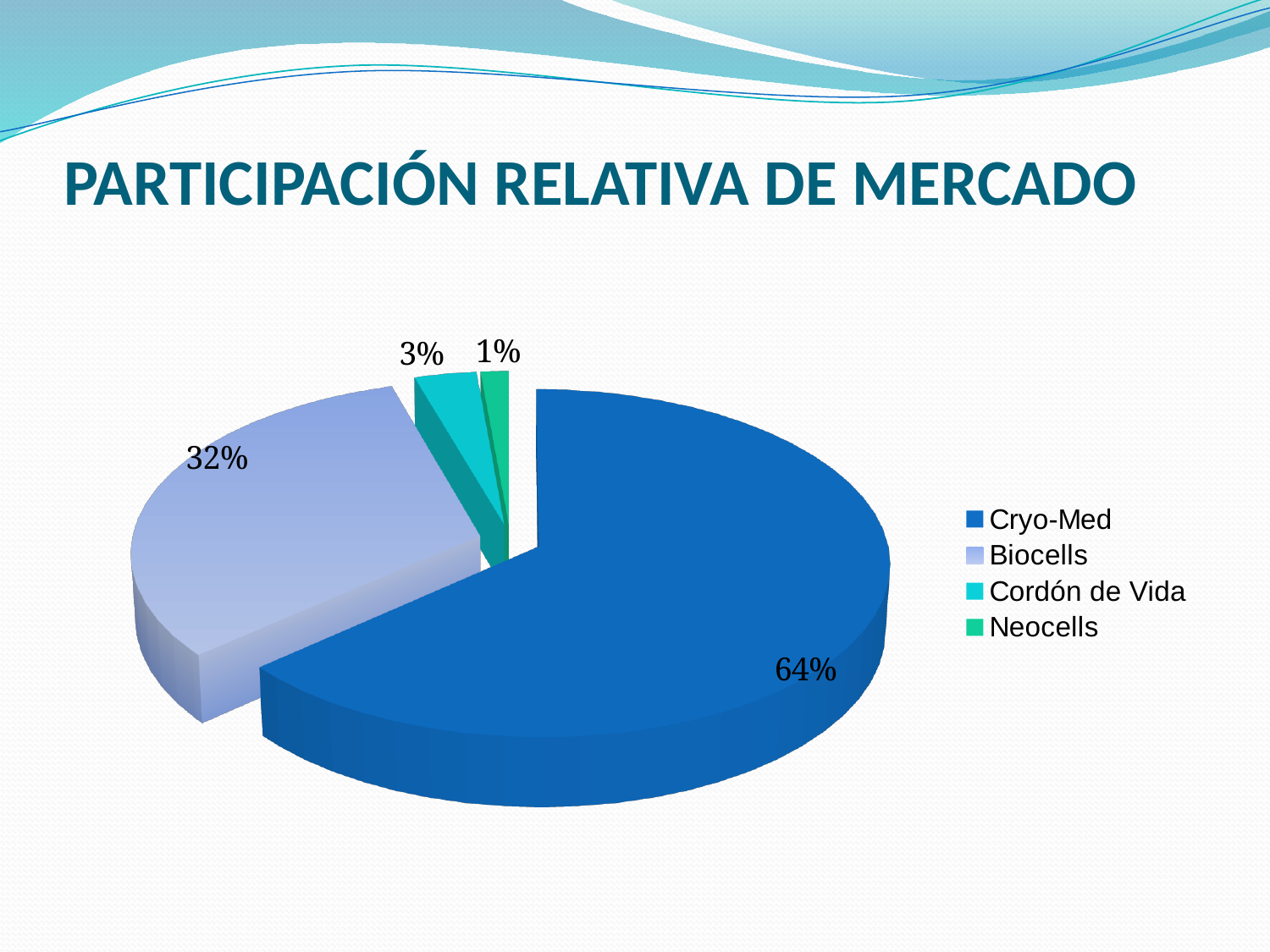
What is the market share for Neocells? 1% What is the difference in market share between Cryo-Med and Biocells? 32% What is the market share for Cryo-Med? 64% What kind of chart is shown on the slide? Pie chart Which company has the smallest market share? Neocells Which has a larger market share, Biocells or Cordón de Vida? Biocells Which company has the largest market share? Cryo-Med How many entries does the legend list? 4 How many slices does the pie chart have? 4 What is the market share for Biocells? 32% What is the title of the slide? PARTICIPACIÓN RELATIVA DE MERCADO What is the market share for Cordón de Vida? 3%